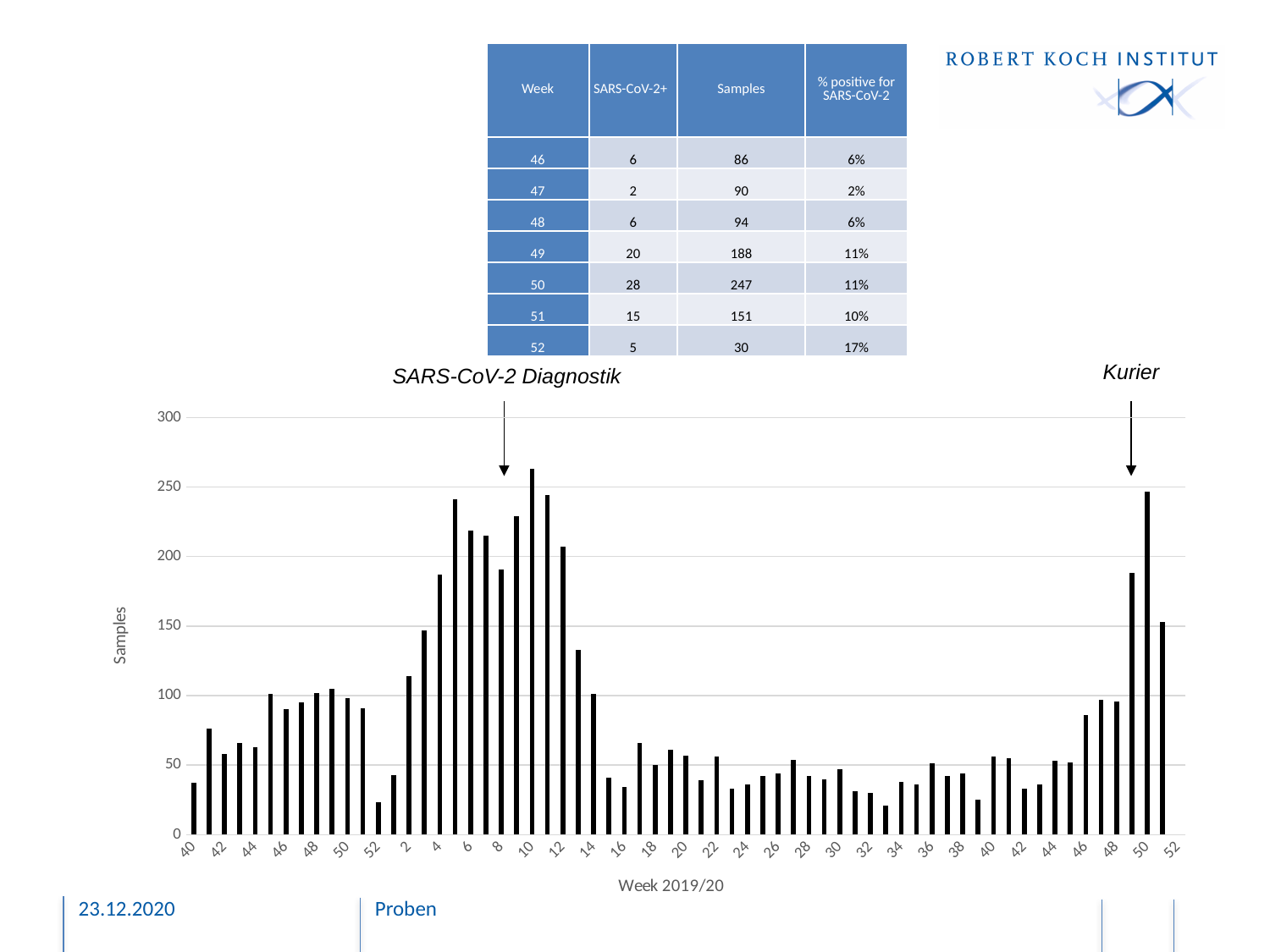
Is the value for the first week 40 bar greater or less than 50? less Is the value for week 2 greater or less than 100? greater Is the value for week 10 greater or less than 250? greater What is the title of the horizontal axis of the chart? Week 2019/20 What is the title of the vertical axis of the chart? Samples Do the values generally rise or fall from week 10 to week 16? fall Which bar is taller, week 2 or week 3? Week 3 What kind of chart is shown on the slide? bar chart Which week has the highest bar in the chart? Week 10 Which bar is taller, week 5 or week 6? Week 5